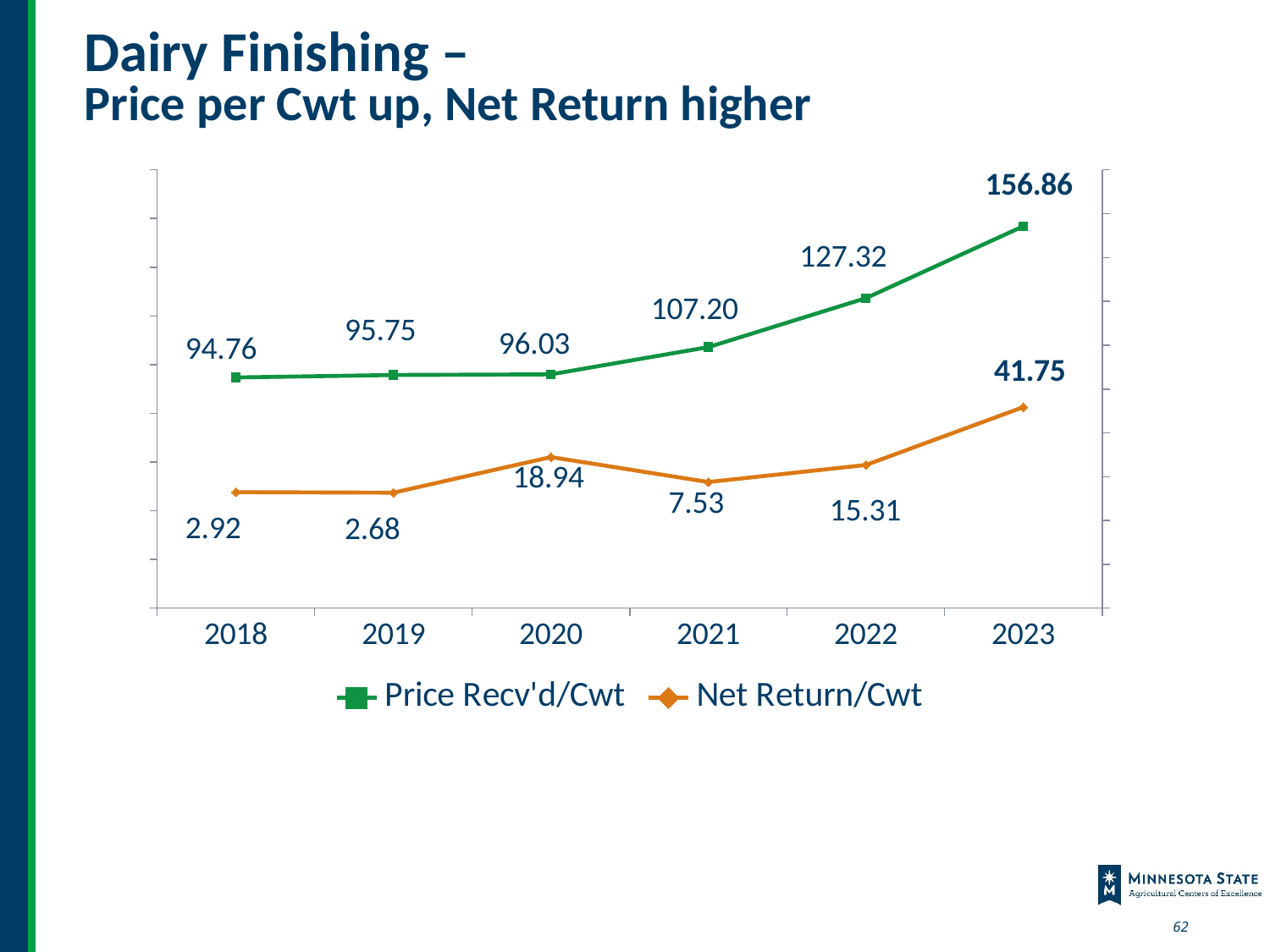
What kind of chart is shown on the slide? Line chart Which is larger, the Net Return/Cwt value for 2020 or for 2021? 2020 What is the Net Return/Cwt value for 2019? 2.68 In which year is Net Return/Cwt lowest? 2019 Does Price Recv'd/Cwt rise or fall from 2020 to 2023? Rise How many years are shown on the x axis? 6 What is the difference between the Price Recv'd/Cwt values for 2023 and 2022? 29.54 What is the Price Recv'd/Cwt value for 2021? 107.20 What is the Price Recv'd/Cwt value for 2023? 156.86 How many series does the legend list? 2 What is the Net Return/Cwt value for 2020? 18.94 In which year is Price Recv'd/Cwt highest? 2023